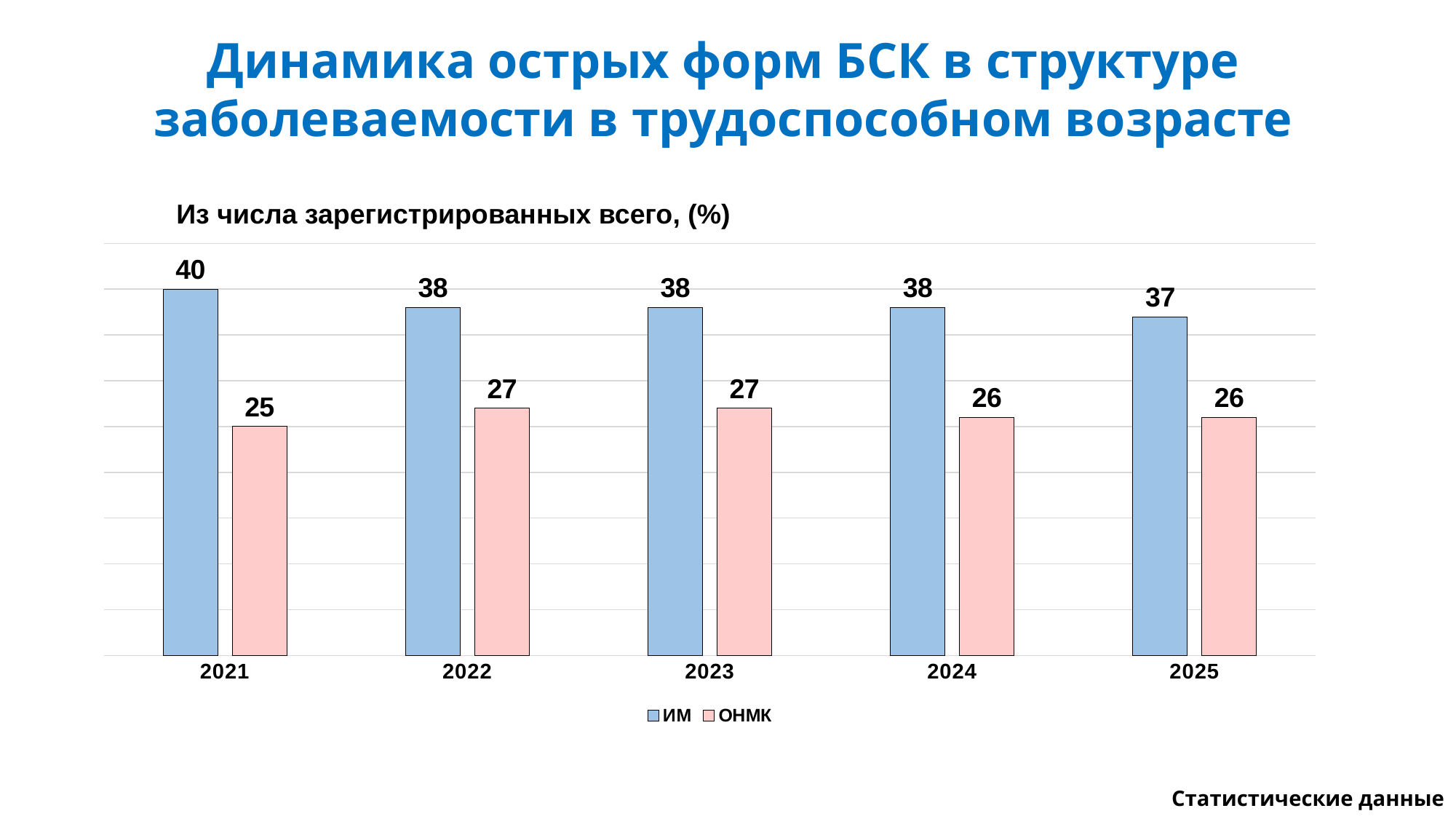
How many years are shown on the x axis? 5 What is the difference between the ИМ value in 2021 and the ИМ value in 2025? 3 What kind of chart is shown on the slide? Bar chart What is the difference between the ИМ and ОНМК values in 2021? 15 What is the value for ОНМК in 2023? 27 Which is larger in 2024, the ИМ value or the ОНМК value? ИМ Does the ИМ value rise or fall from 2021 to 2025? Fall In which year is the ИМ value highest? 2021 How many series does the legend list? 2 In which year is the ОНМК value lowest? 2021 What is the value for ИМ in 2025? 37 What is the value for ИМ in 2021? 40